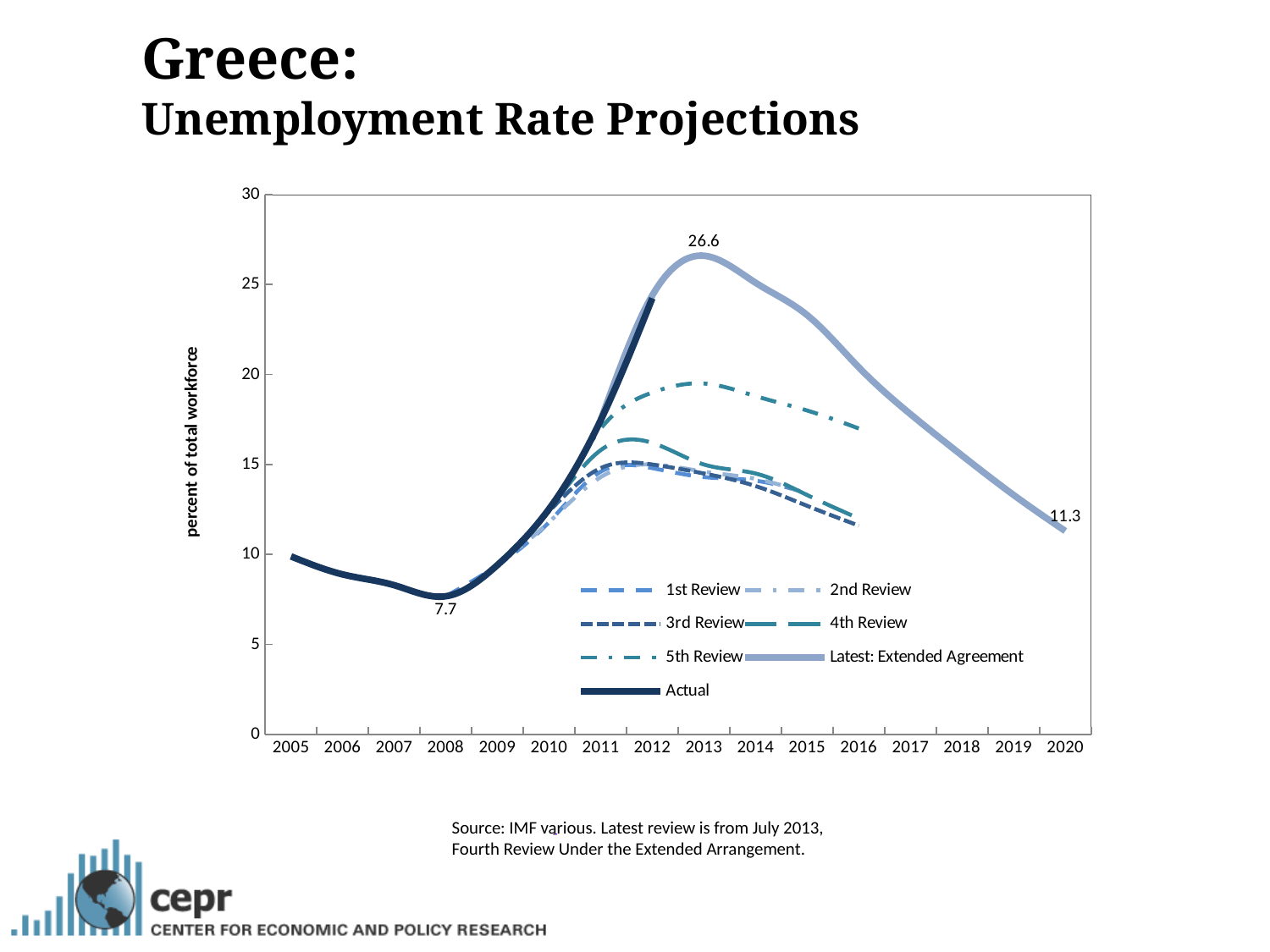
How many series does the legend list? 7 Is the value of the 5th Review line in 2013 greater or less than 15? greater What is the peak value labelled on the Latest: Extended Agreement line in 2013? 26.6 Does the Actual line rise or fall between 2008 and 2012? rise What is the label on the vertical axis? percent of total workforce What is the difference between the labelled 2013 peak (26.6) and the labelled 2020 value (11.3) on the Latest: Extended Agreement line? 15.3 What value is labelled at the end of the Latest: Extended Agreement line in 2020? 11.3 What value is labelled at the low point of the Actual line in 2008? 7.7 What is the difference between the labelled 2013 peak of 26.6 and the labelled 2008 low of 7.7? 18.9 What kind of chart is shown on the slide? line chart In 2016, which line is higher: the 5th Review or the 3rd Review? 5th Review